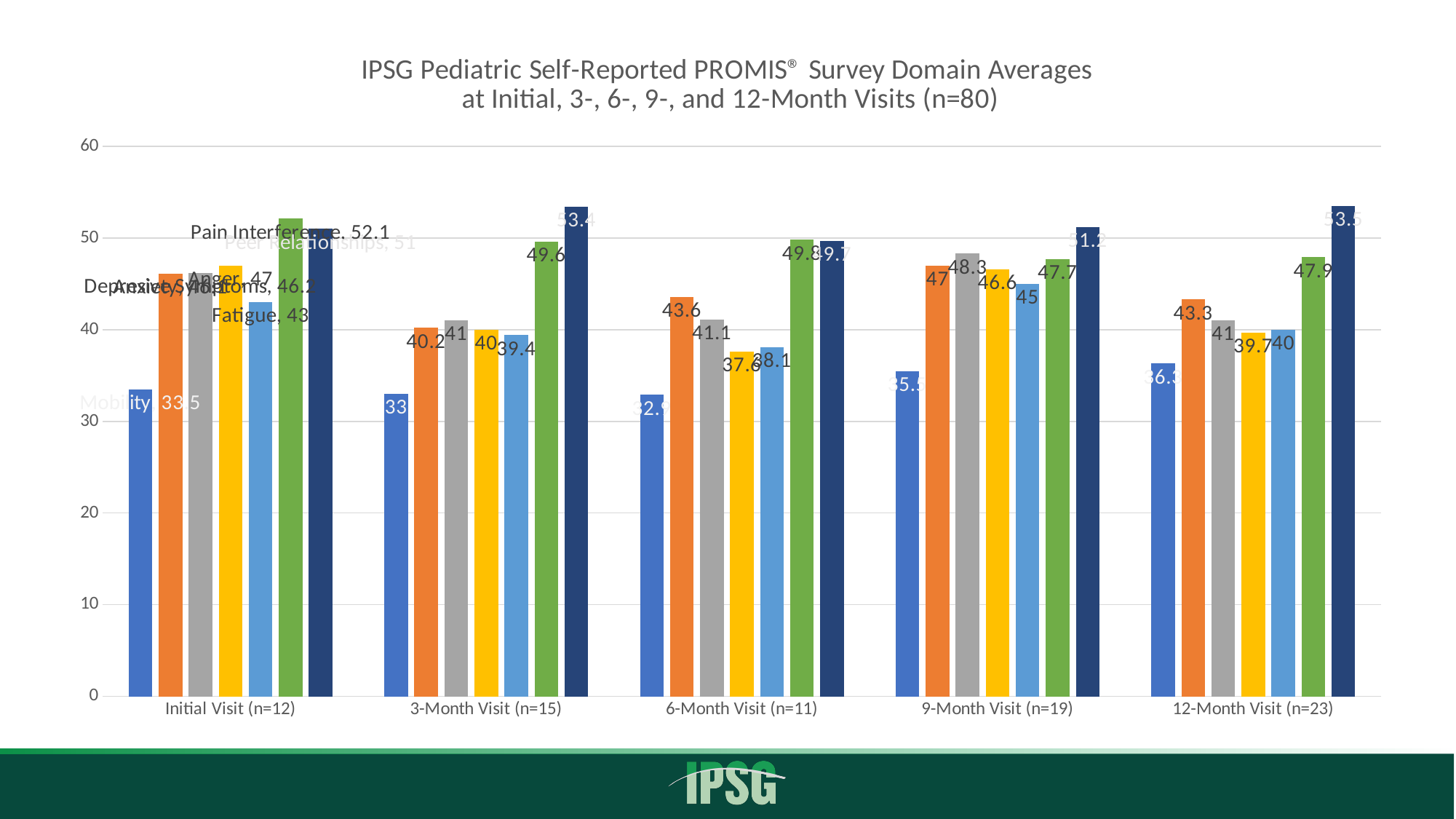
How many bars are plotted in each visit group? 7 Which is larger: the first (blue) bar in the 12-Month Visit group or the first (blue) bar in the 3-Month Visit group? 12-Month Visit At the Initial Visit, what is the difference between the Pain Interference value and the Fatigue value? 9.1 What is the lowest labeled value in the 9-Month Visit (n=19) group? 35.5 What is the highest labeled value in the 3-Month Visit (n=15) group? 53.4 What is the Pain Interference value at the Initial Visit? 52.1 What is the Peer Relationships value at the Initial Visit? 51 What is the Fatigue value at the Initial Visit? 43 How many visit groups are shown along the x axis? 5 What type of chart is shown on the slide? Bar chart What is the value of the rightmost (dark blue) bar in the 12-Month Visit (n=23) group? 53.5 What is the Mobility value at the Initial Visit? 33.5